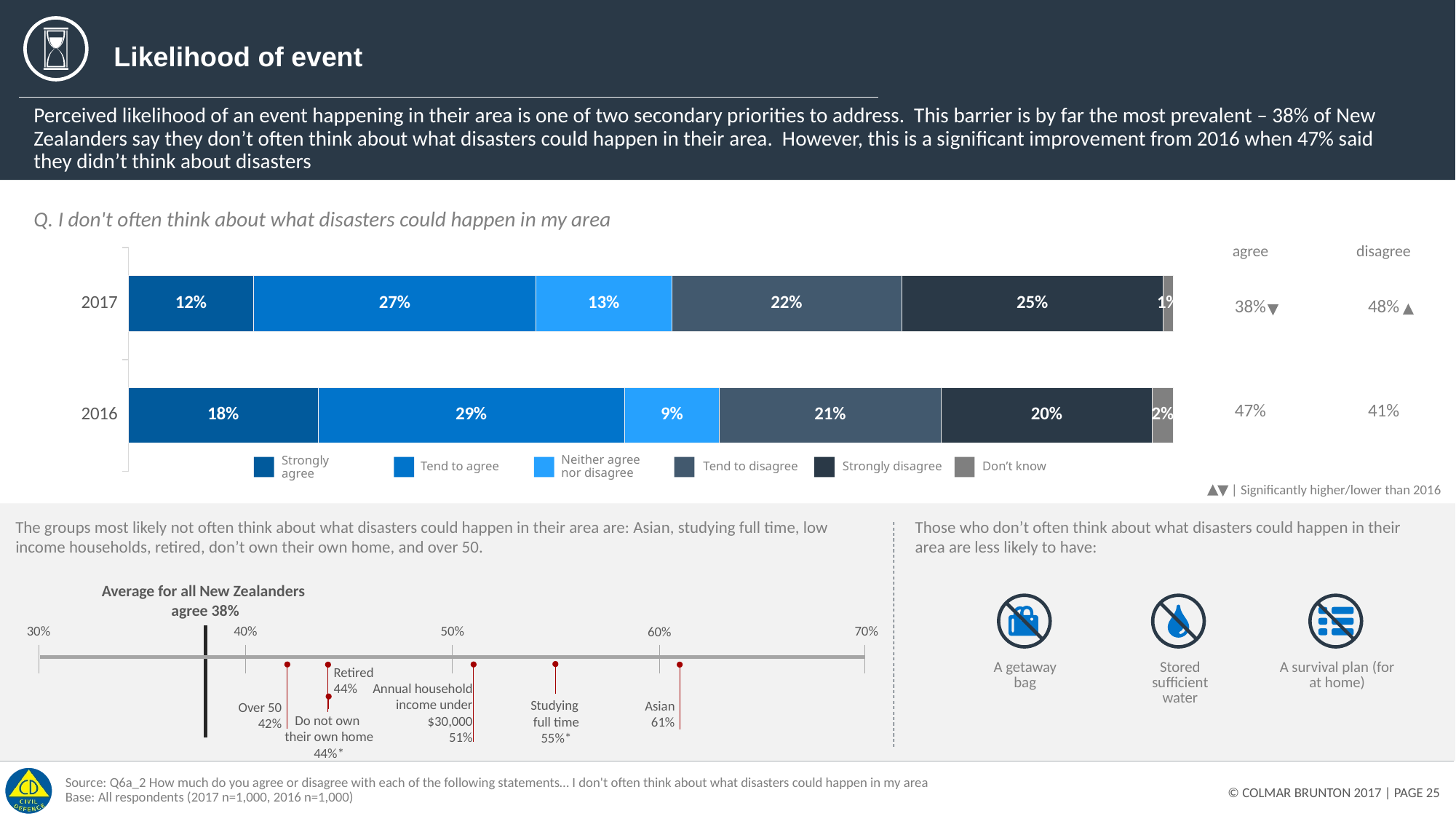
In the stacked bar chart, what is the total of the 2017 bar segments? 100% In the dot plot at the bottom left, what is the value for Asian? 61% How many series does the legend of the stacked bar chart list? 6 In the stacked bar chart, what percentage of respondents in 2016 said they tend to agree? 29% In the stacked bar chart, which year has the larger 'Strongly disagree' share, 2017 or 2016? 2017 In the dot plot at the bottom left, what is the average for all New Zealanders marked by the vertical line? 38% How many years are shown in the stacked bar chart? 2 In the stacked bar chart, what percentage of respondents in 2017 said they strongly agree? 12% In the stacked bar chart, by how many percentage points did the 'Strongly agree' share fall from 2016 to 2017? 6 percentage points What kind of chart is used to show the 2017 and 2016 responses? Stacked bar chart In the dot plot at the bottom left, which group has the highest value? Asian In the dot plot at the bottom left, which group has the lowest value? Over 50